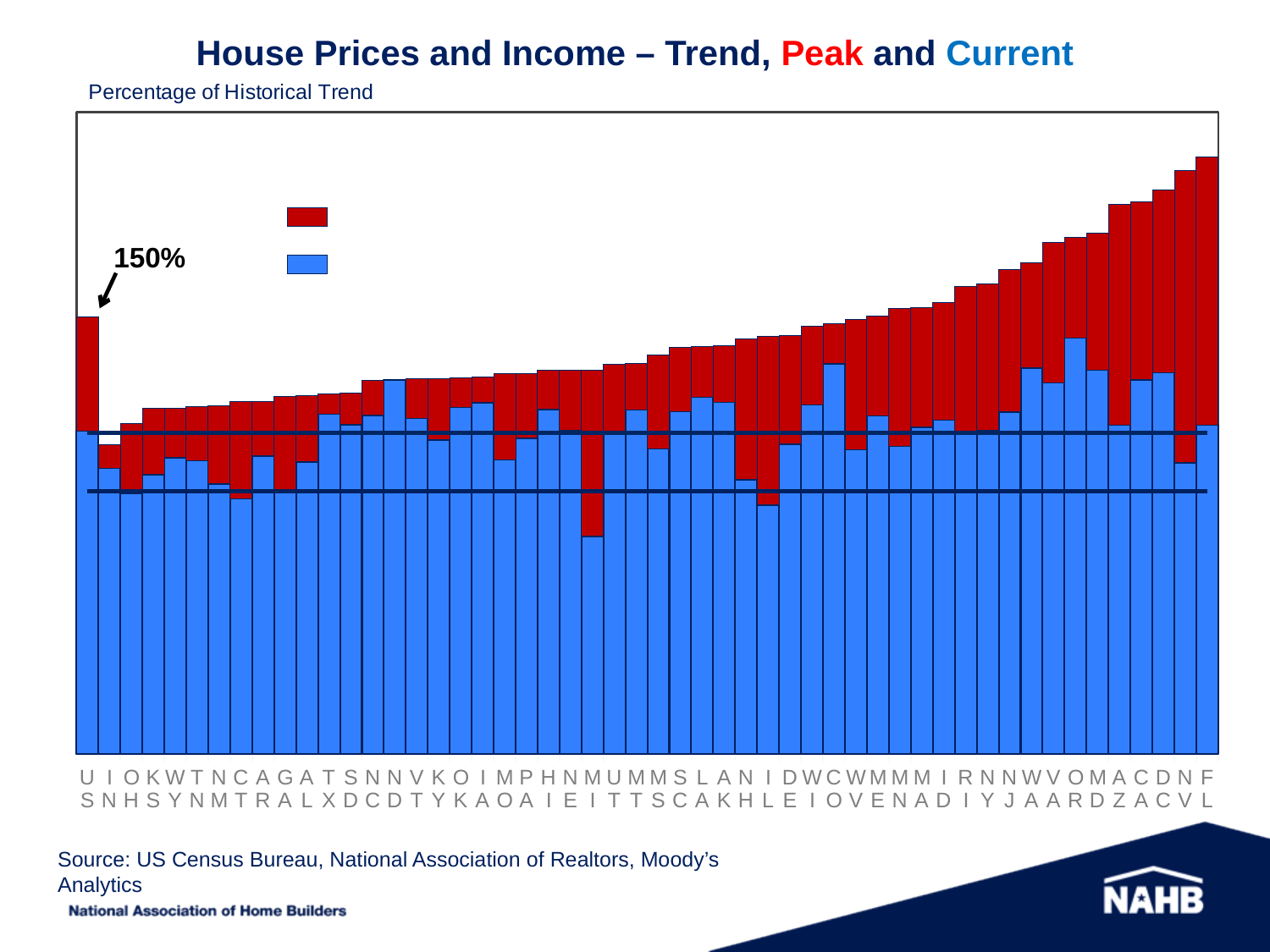
What does the label above the chart say the values are measured as? Percentage of Historical Trend What kind of chart is shown on the slide? bar chart What is the title of the chart? House Prices and Income – Trend, Peak and Current Which category has the tallest red (Peak) bar? NV Which has the taller red (Peak) bar, US or FL? FL How many categories are plotted along the x axis? 52 What value is labelled for the first bar (US) in the chart? 150% How many series does the legend show? 2 Do the red (Peak) bars generally rise or fall from left to right along the x axis? rise